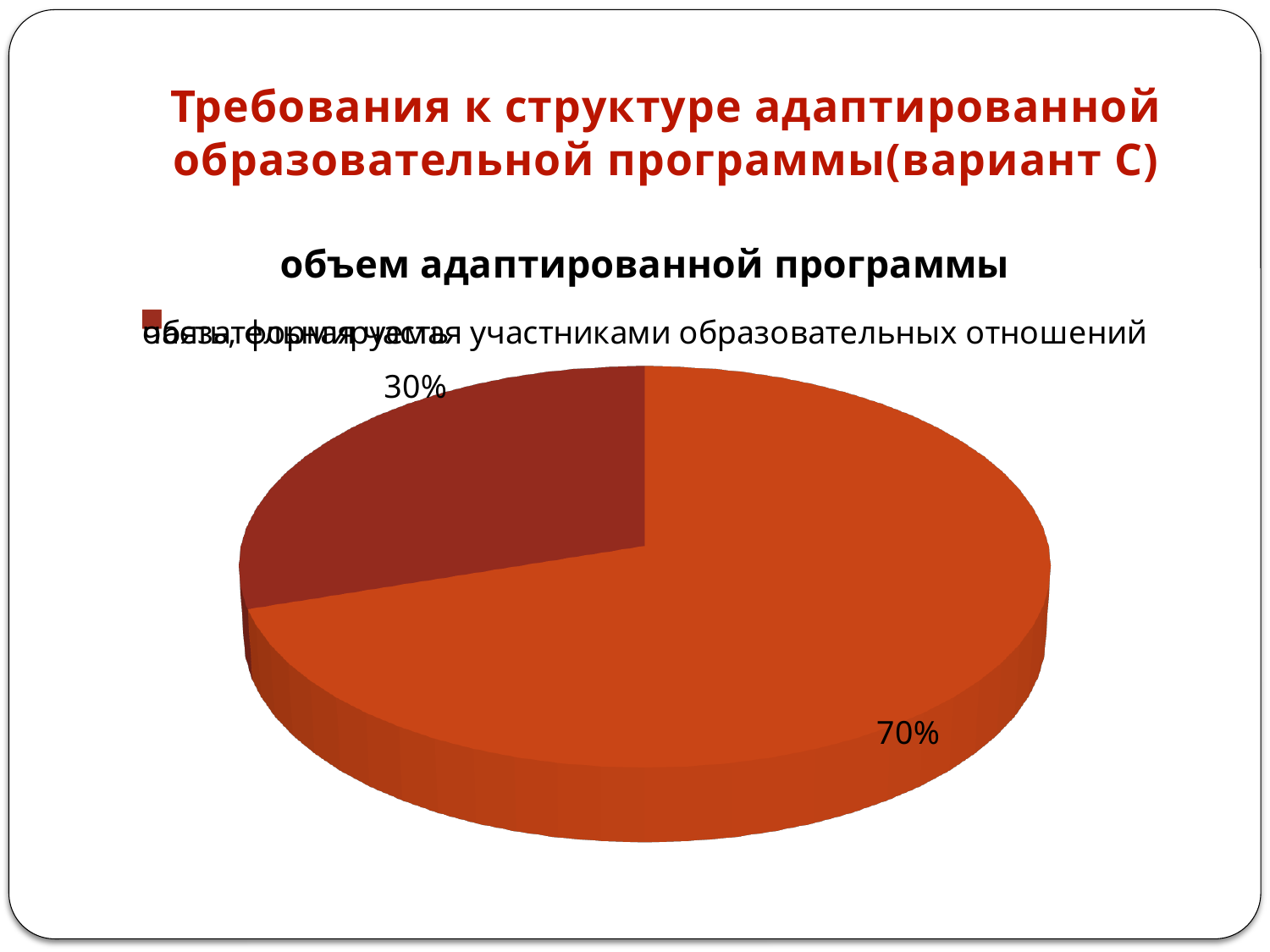
What share of the pie does the darker red slice represent? 30% Which slice is larger: the one labelled 70% or the one labelled 30%? 70% Is the value of the smaller slice greater or less than 50%? less Is the value of the larger slice greater or less than 50%? greater What kind of chart is shown on the slide? pie chart What percentage is shown on the smallest slice of the pie chart? 30% What percentage is shown on the largest slice of the pie chart? 70% What is the difference in percentage points between the two slices of the pie chart? 40 What is the title of the chart? объем адаптированной программы What is the total of the two percentages shown on the pie chart? 100% How many slices does the pie chart have? 2